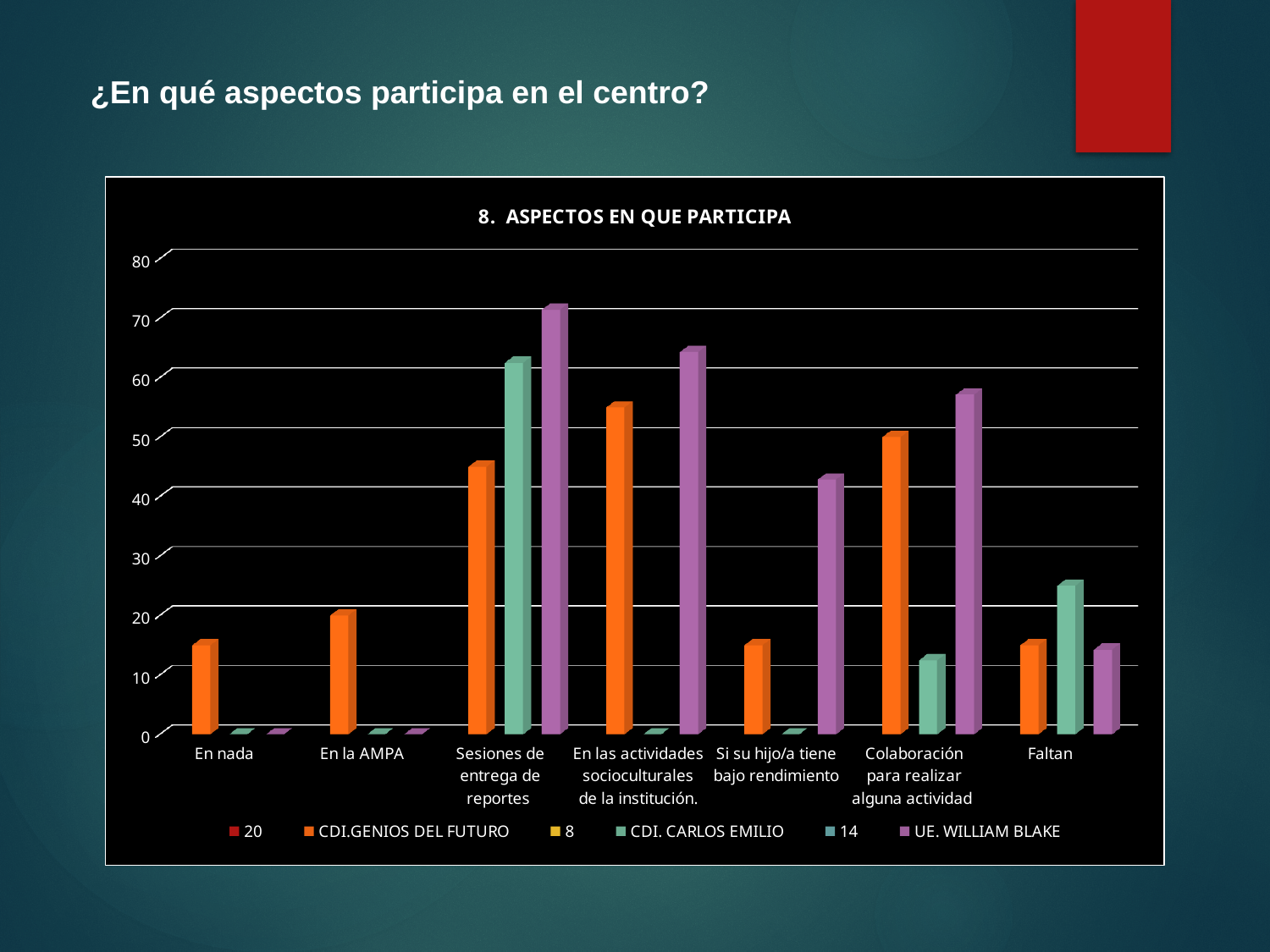
In which category does CDI.GENIOS DEL FUTURO have its highest value? En las actividades socioculturales de la institución. What is the title of the chart? 8. ASPECTOS EN QUE PARTICIPA Is the value for UE. WILLIAM BLAKE in the category 'Sesiones de entrega de reportes' greater or less than 60? greater In which category does UE. WILLIAM BLAKE have its highest value? Sesiones de entrega de reportes How many categories are shown along the x axis of the chart? 7 In the category 'Sesiones de entrega de reportes', which is larger: CDI. CARLOS EMILIO or CDI.GENIOS DEL FUTURO? CDI. CARLOS EMILIO In the category 'Faltan', which is larger: CDI. CARLOS EMILIO or UE. WILLIAM BLAKE? CDI. CARLOS EMILIO Is the value for CDI.GENIOS DEL FUTURO in the category 'En la AMPA' greater or less than 30? less How many series does the chart legend list? 6 What kind of chart is shown on the slide? Bar chart Is the value for CDI. CARLOS EMILIO in the category 'Colaboración para realizar alguna actividad' greater or less than 20? less